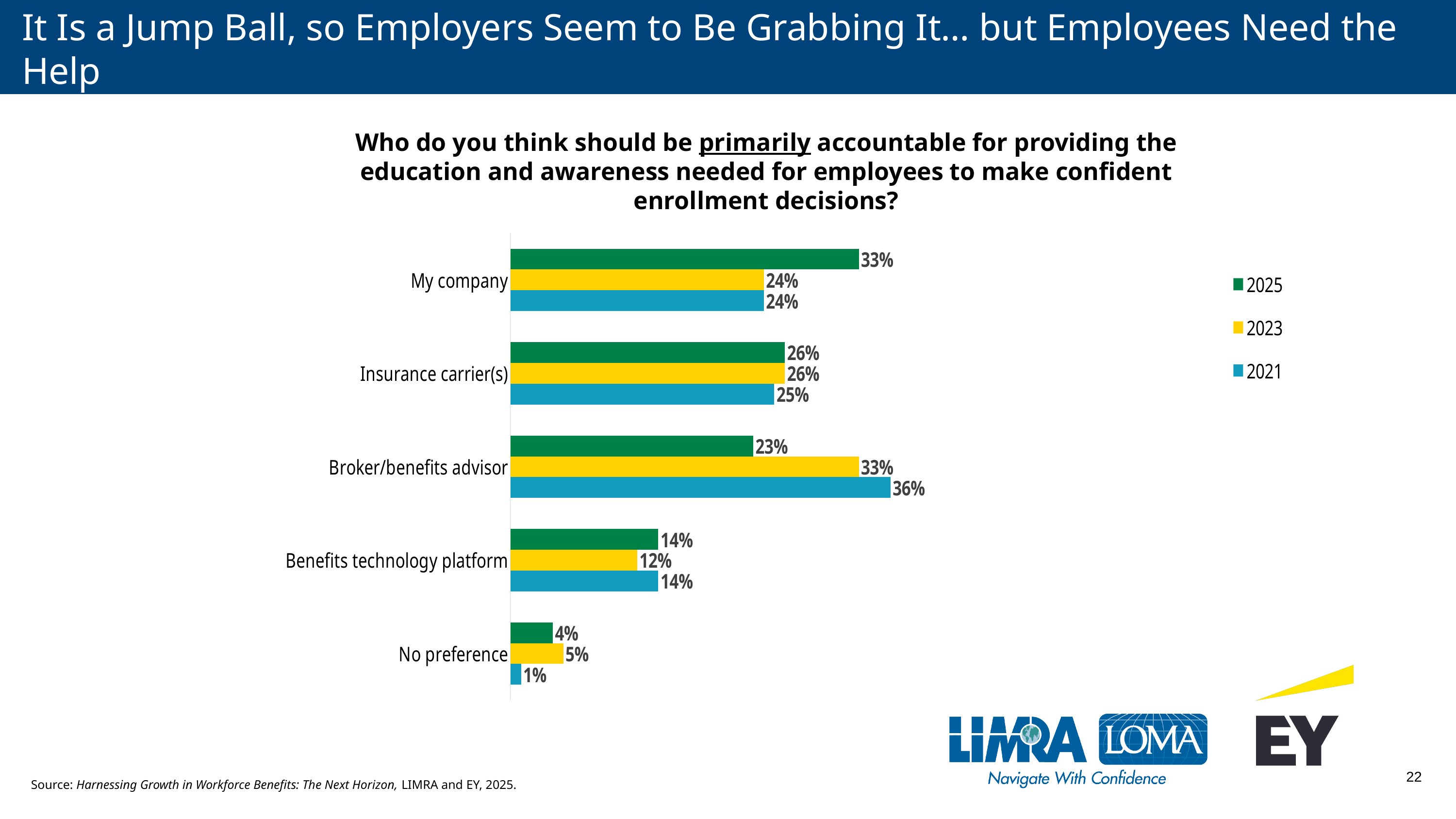
What is the 2023 value for 'Benefits technology platform'? 12% Which category has the lowest value for 2021? No preference Which colour represents the 2023 series in the legend? Yellow Which category has the highest value for 2025? My company How many series does the legend list? 3 What kind of chart is shown on the slide? Bar chart What is the difference between the 2021 and 2025 values for 'Broker/benefits advisor'? 13% What is the 2021 value for 'Broker/benefits advisor'? 36% Which is larger for 'Broker/benefits advisor': the 2025 value or the 2023 value? 2023 What percentage of respondents chose 'My company' in 2025? 33% How many categories are shown on the chart? 5 What is the difference between the 2025 and 2023 values for 'My company'? 9%